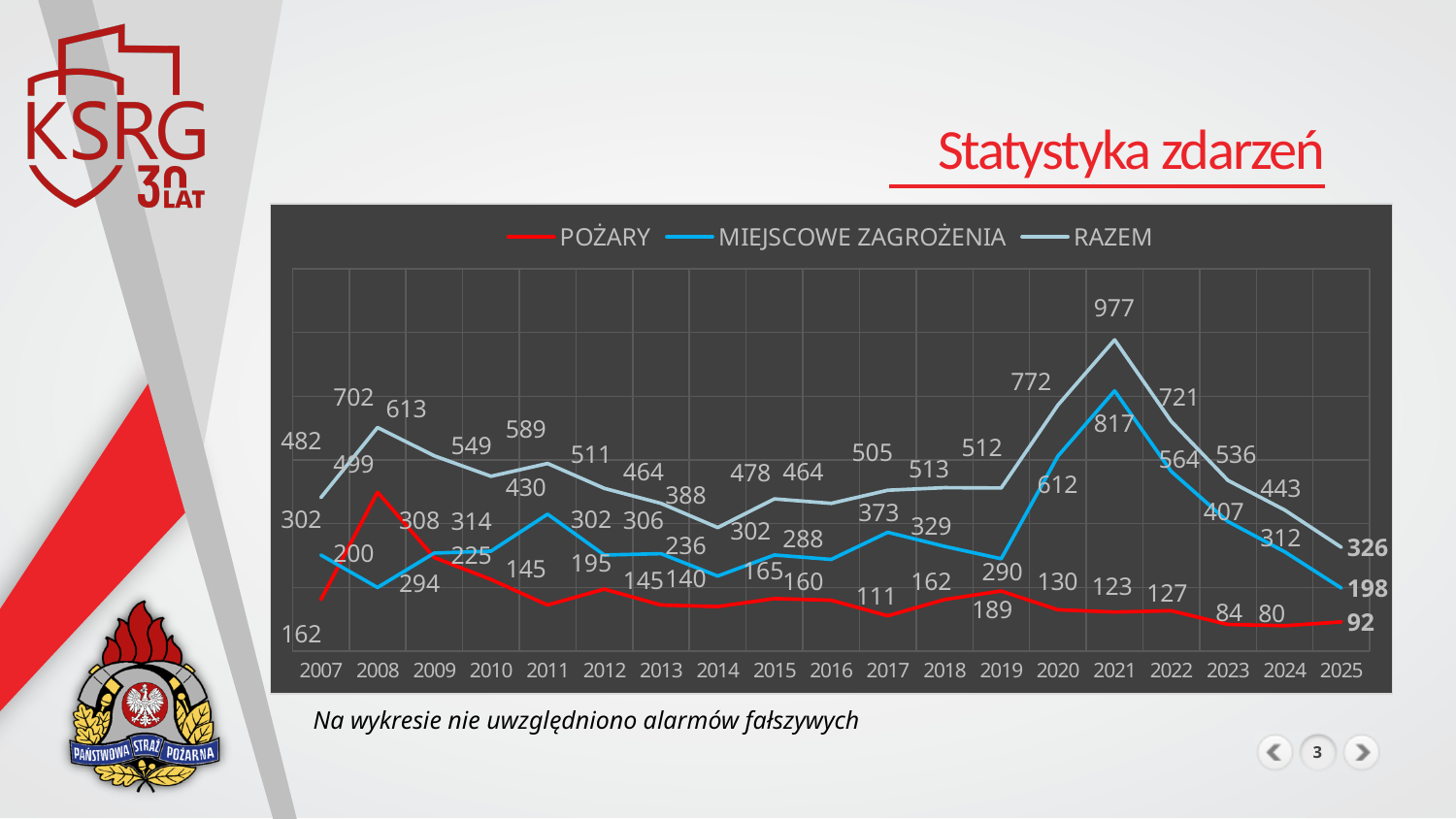
How many series does the legend list? 3 What is the POŻARY value for 2025? 92 What is the RAZEM value for 2021? 977 What kind of chart is shown on the slide? line chart In which year does the RAZEM series reach its highest value? 2021 What is the difference between the RAZEM values for 2021 and 2025? 651 What is the MIEJSCOWE ZAGROŻENIA value for 2025? 198 In 2008, which is larger: POŻARY or MIEJSCOWE ZAGROŻENIA? POŻARY In which year does the POŻARY series reach its highest value? 2008 In which year is the RAZEM value lowest? 2025 How many years are plotted along the x axis? 19 What is the title of the slide containing the chart? Statystyka zdarzeń